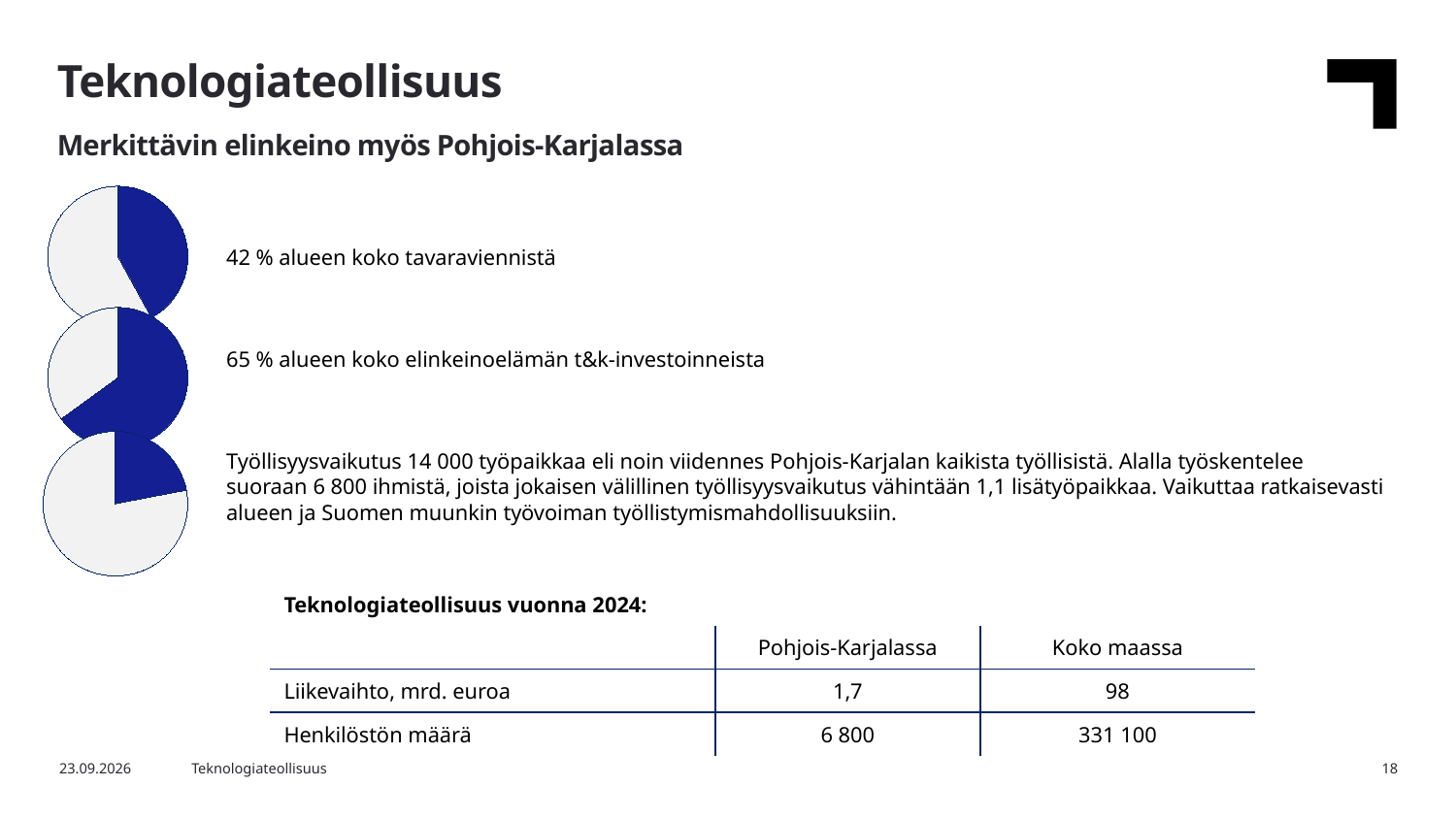
What colour is used for the highlighted slice in each pie chart? Blue Is the blue slice in the bottom pie chart greater or less than 50 %? less Which is larger: the blue share in the top pie chart or the blue share in the middle pie chart? The middle pie chart In the middle pie chart, what share of the region's business R&D investments does the blue slice represent? 65 % Which of the three pie charts has the largest blue slice? The middle pie chart (65 %) What is the difference between the blue share in the middle pie chart (65 %) and the blue share in the top pie chart (42 %)? 23 percentage points How many slices does each pie chart have? 2 In the top pie chart, what share of the region's total goods exports does the blue slice represent? 42 % Is the blue slice in the middle pie chart greater or less than 50 %? greater What kind of charts are shown on the left side of the slide? Pie charts Which of the three pie charts has the smallest blue slice? The bottom pie chart How many pie charts are on the slide? 3